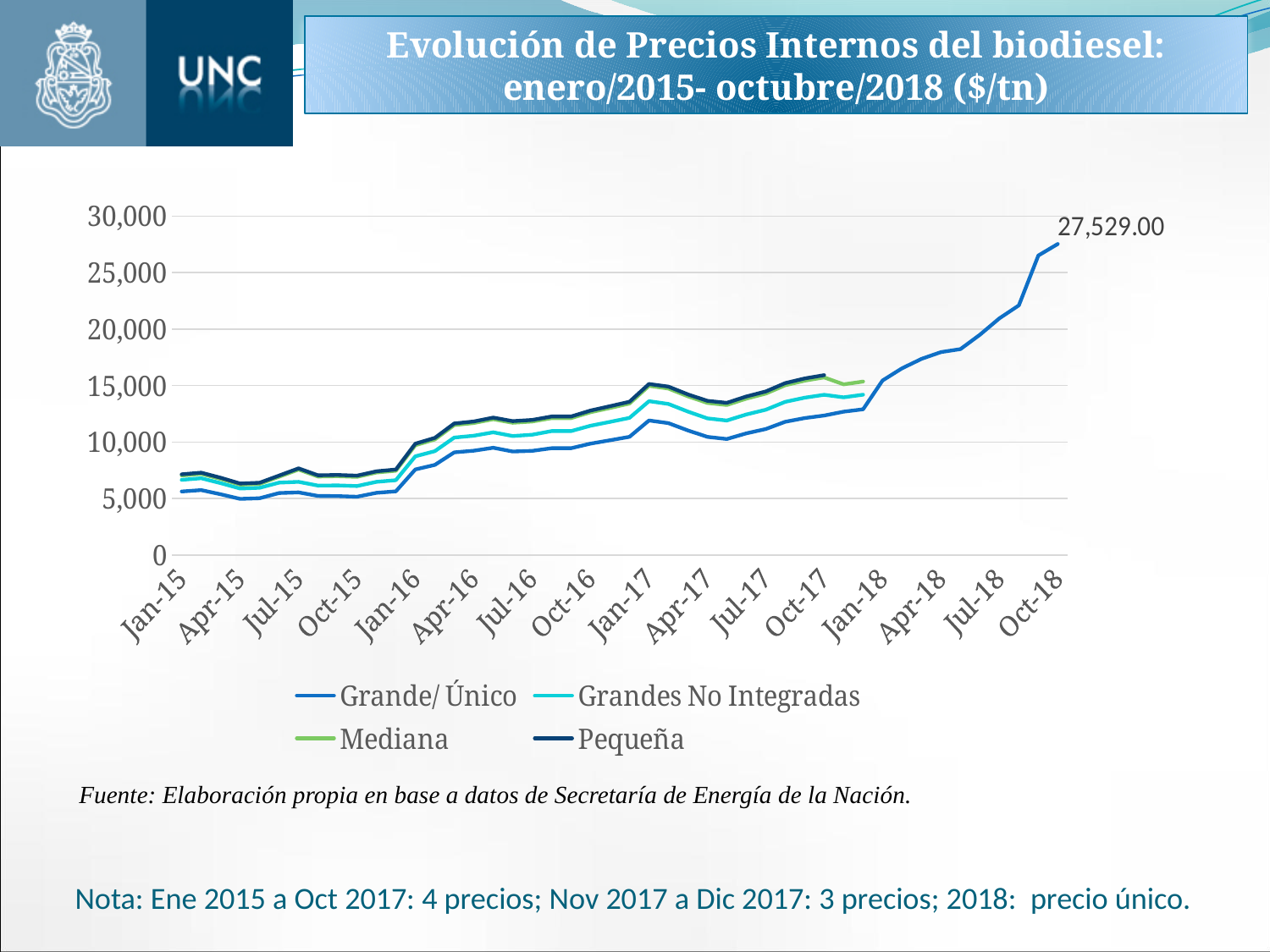
Is the value for Grande/ Único at Oct-18 greater or less than 25,000? greater What is the value of the Grande/ Único series at Oct-18? 27,529.00 Is the value for Pequeña at Jan-17 greater or less than 10,000? greater Which series has the highest values during 2016? Pequeña What kind of chart is shown on the slide? line chart Does the Grande/ Único series generally rise or fall from Jan-15 to Oct-18? rise Which series has the lowest values during 2016? Grande/ Único At Jan-15, which is larger: the Pequeña value or the Grande/ Único value? Pequeña What is the title of the chart? Evolución de Precios Internos del biodiesel: enero/2015- octubre/2018 ($/tn) Is the value for Grande/ Único at Jan-15 greater or less than 10,000? less How many series does the legend list? 4 How many tick labels are shown on the x axis? 16